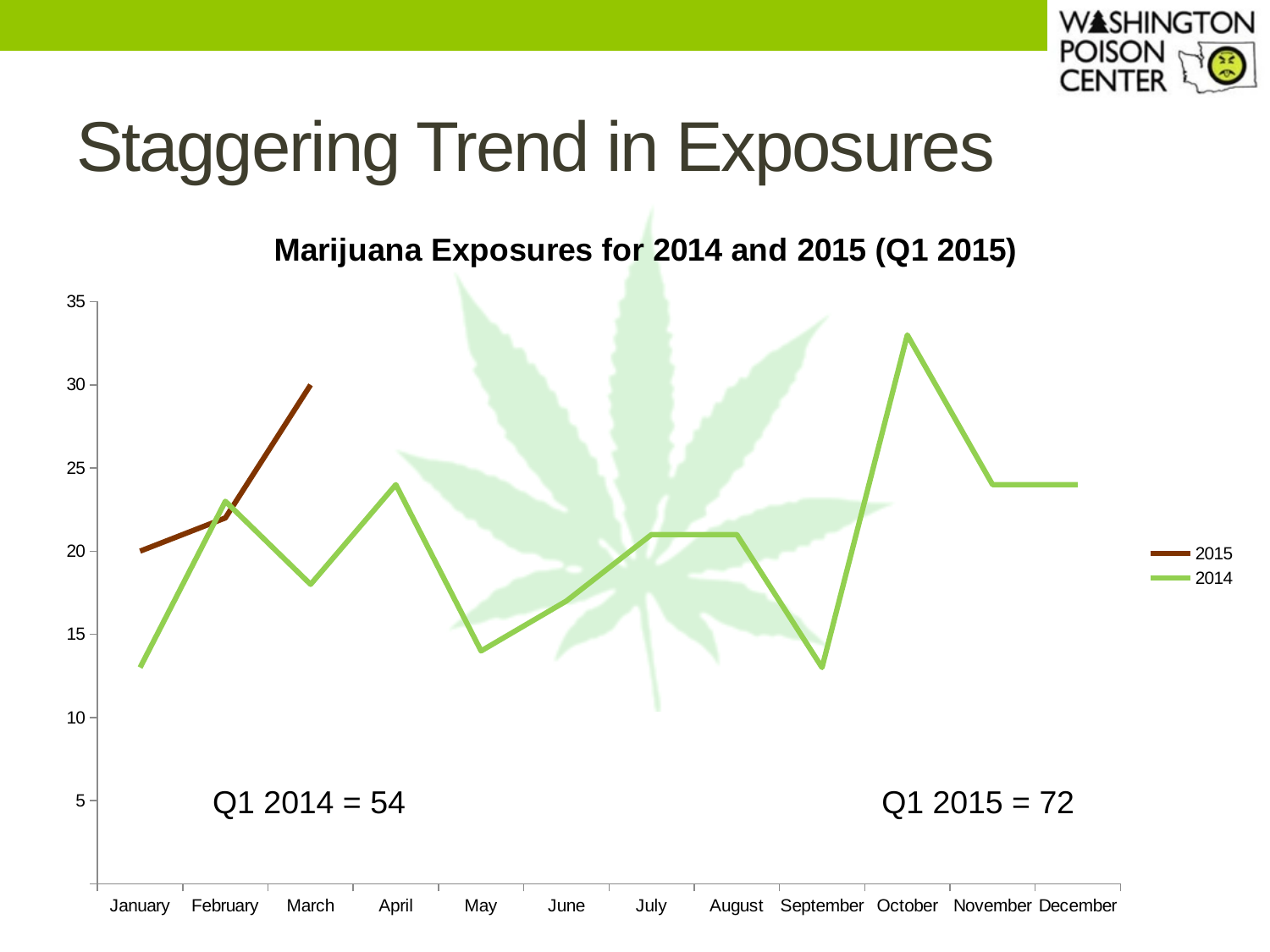
What total is given on the slide for Q1 2015? 72 How many months are shown along the x axis? 12 Is the 2014 value for May greater or less than 15? less In which month does the 2015 series reach its highest value? March Does the 2015 line rise or fall from January to March? rise In which month does the 2014 series reach its highest value? October Is the 2014 value for October greater or less than 30? greater Which is larger for 2014, the value for April or the value for May? April How many series does the legend list? 2 What is the title of the chart? Marijuana Exposures for 2014 and 2015 (Q1 2015) What kind of chart is shown on the slide? line chart What total is given on the slide for Q1 2014? 54